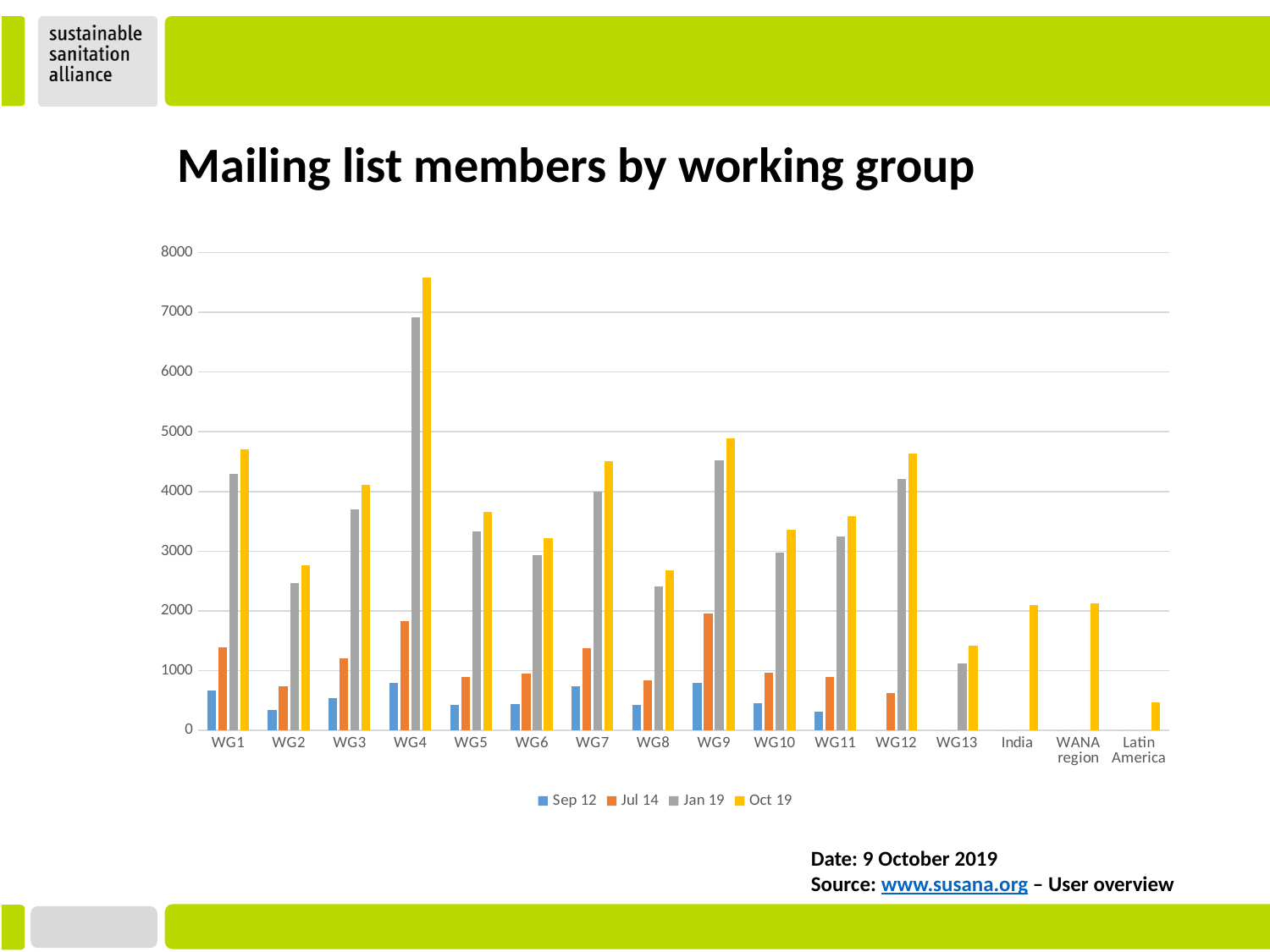
Which category has the highest Oct 19 value? WG4 What kind of chart is shown on the slide? bar chart Which category has the lowest Oct 19 value? Latin America How many series does the legend list? 4 How many categories are shown on the x axis? 16 Which is larger, the Oct 19 value for WG7 or for WG8? WG7 What is the title of the chart? Mailing list members by working group Is the Oct 19 value for WG13 greater or less than 2000? less Is the Oct 19 value for WG4 greater or less than 7000? greater Is the Oct 19 value for WG2 greater or less than 3000? less Which category has the highest Jan 19 value? WG4 For WG1, do the values rise or fall from Sep 12 to Oct 19? rise